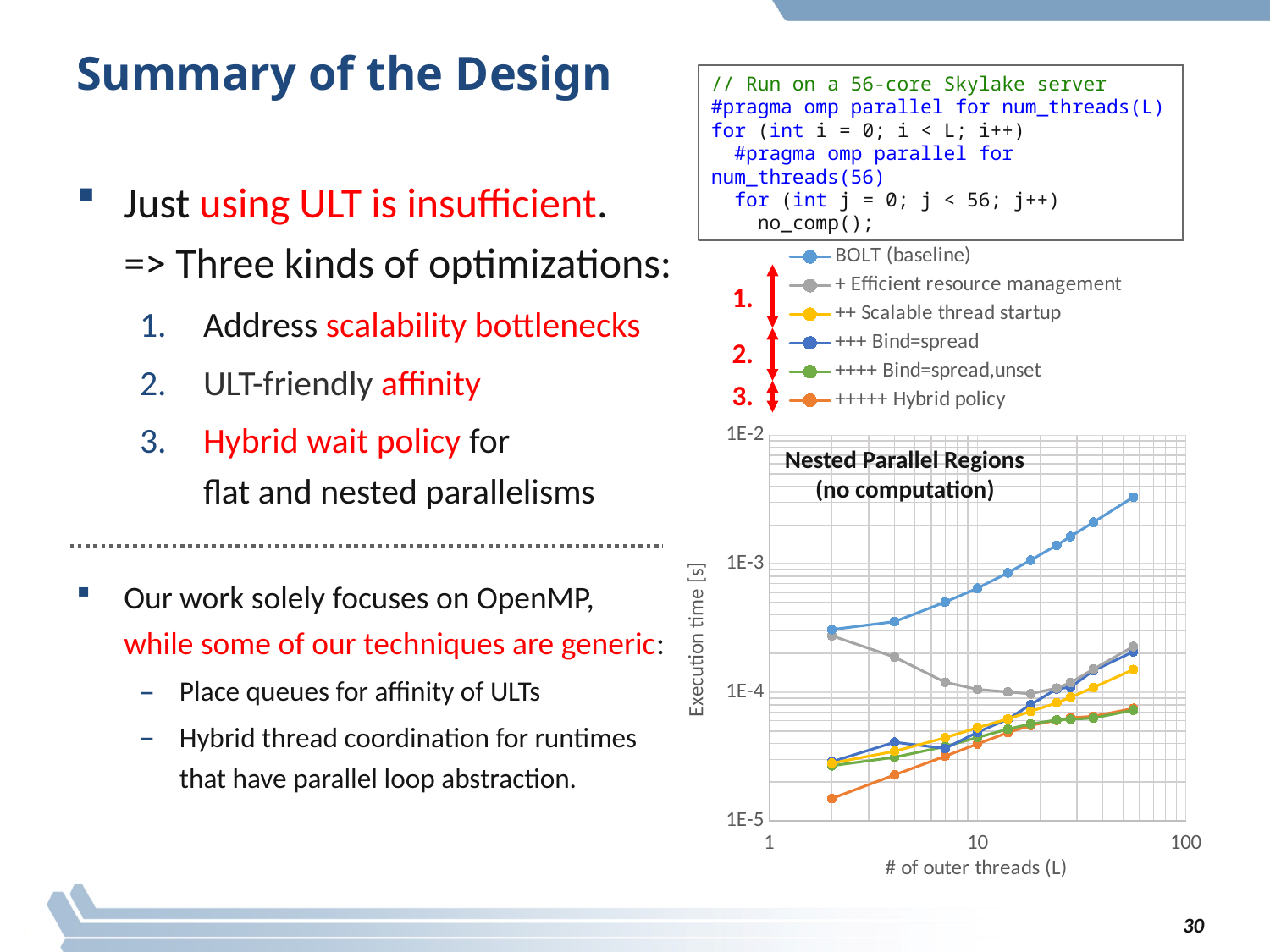
What is the title of the chart? Nested Parallel Regions (no computation) Is the execution time of BOLT (baseline) at the largest number of outer threads greater or less than 1E-3? greater What kind of chart is shown on the slide? line chart Does the execution time of +++++ Hybrid policy rise or fall as the number of outer threads increases? rise What is the label of the x axis of the chart? # of outer threads (L) Which series has the highest execution time at the largest number of outer threads? BOLT (baseline) Is the execution time of +++++ Hybrid policy at 2 outer threads greater or less than 1E-4? less How many series does the chart legend list? 6 At the largest number of outer threads, which has the larger execution time: BOLT (baseline) or +++++ Hybrid policy? BOLT (baseline) Which series has the lowest execution time at 2 outer threads? +++++ Hybrid policy Is the execution time of BOLT (baseline) at 2 outer threads greater or less than 1E-4? greater Does the execution time of BOLT (baseline) rise or fall as the number of outer threads increases? rise